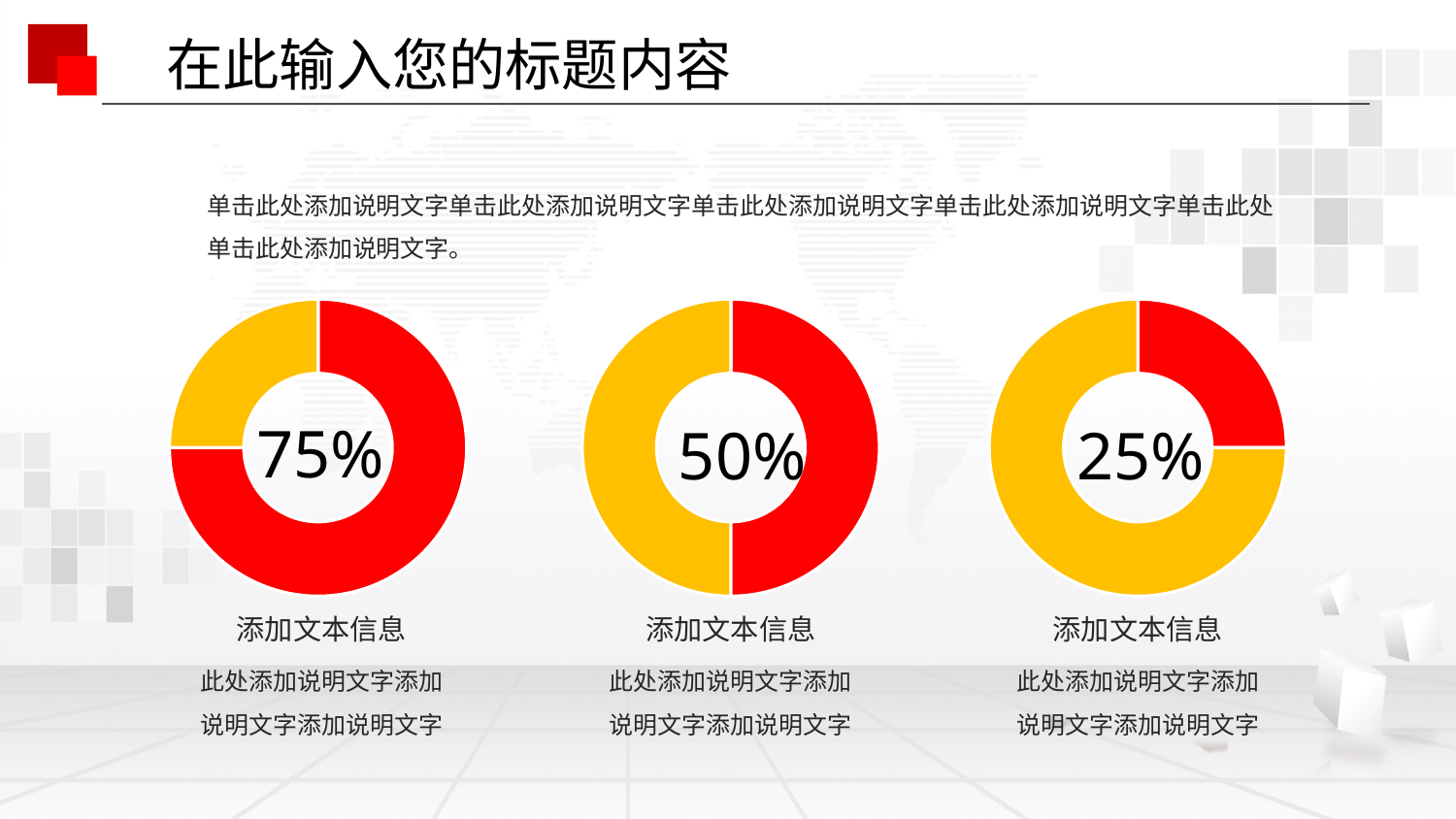
What is the difference between the percentage in the left donut chart and the percentage in the right donut chart? 50% Which donut chart shows the highest percentage: left, middle or right? left What percentage is printed in the centre of the right donut chart? 25% What percentage is printed in the centre of the middle donut chart? 50% In the right donut chart, what share of the ring is filled red? 25% Which is larger, the percentage in the middle donut chart or the percentage in the right donut chart? middle How many donut charts are on the slide? 3 What two colours are used for the segments of the donut charts? red and yellow In the left donut chart, what share of the ring is filled red? 75% Which donut chart shows the lowest percentage: left, middle or right? right What percentage is printed in the centre of the left donut chart? 75% What kind of chart is shown on the left of the slide? donut chart